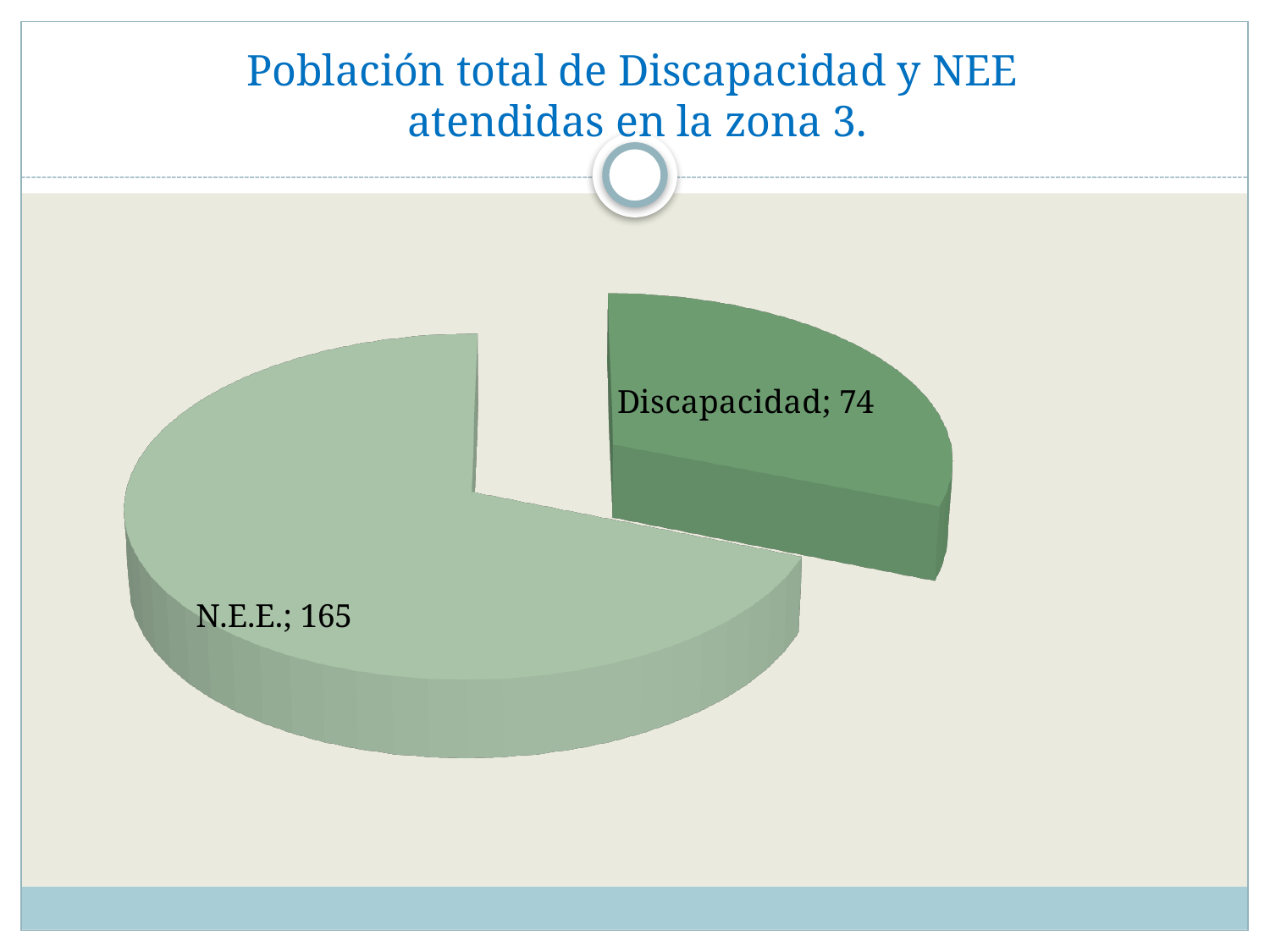
What kind of chart is shown on the slide? Pie chart Which slice is pulled out from the rest of the pie? Discapacidad What is the value for Discapacidad? 74 Which is larger, Discapacidad or N.E.E.? N.E.E. How many slices does the pie chart have? 2 Which category has the largest slice? N.E.E. What is the title of the slide? Población total de Discapacidad y NEE atendidas en la zona 3. What is the total of the two slices? 239 What is the value for N.E.E.? 165 Which category has the smallest slice? Discapacidad What is the difference between the N.E.E. value and the Discapacidad value? 91